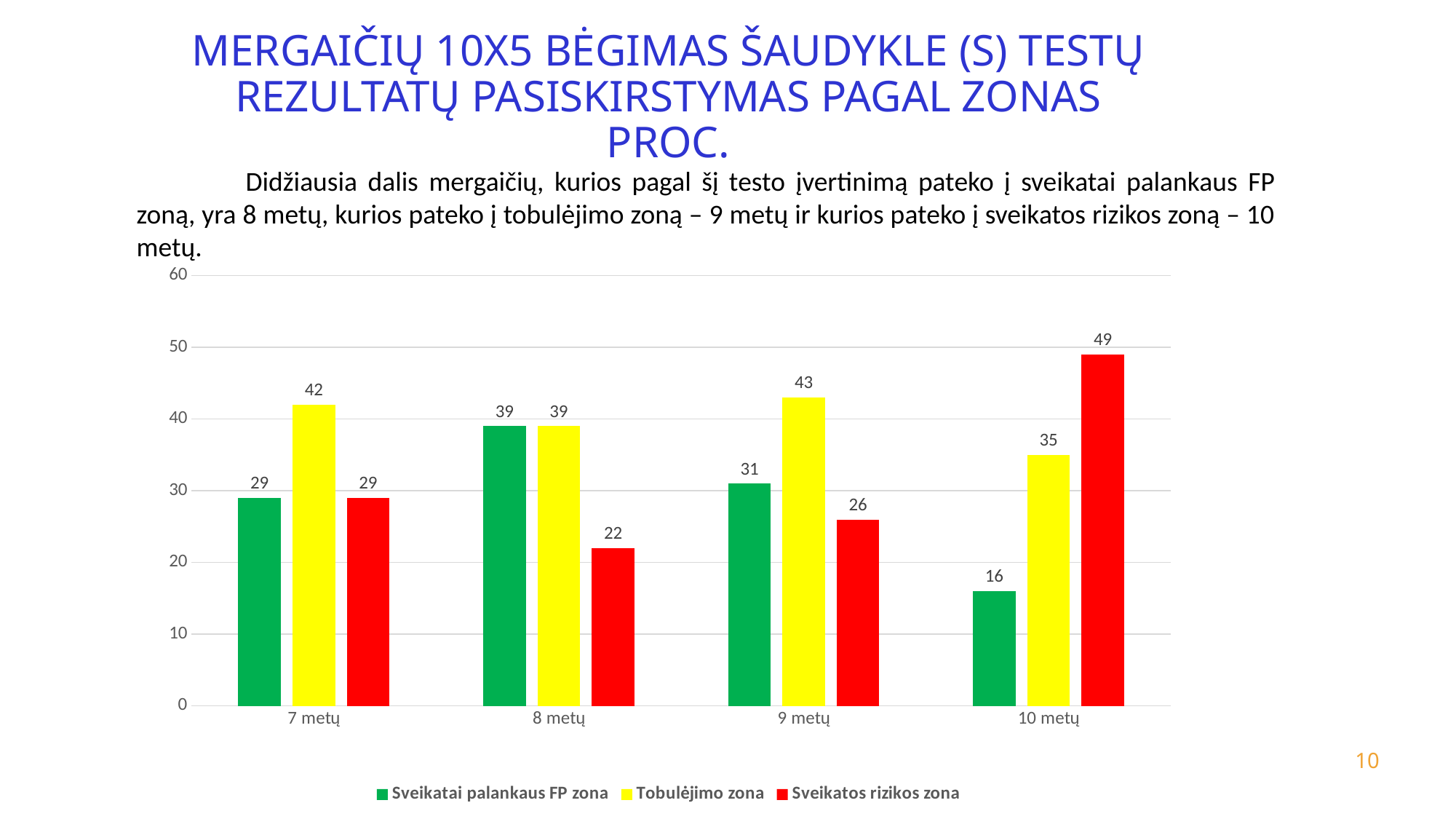
What is the difference between the Tobulėjimo zona and Sveikatos rizikos zona values at 8 metų? 17 What is the value for Tobulėjimo zona at 9 metų? 43 What is the value for Sveikatos rizikos zona at 10 metų? 49 What kind of chart is shown on the slide? Bar chart Do the values for Sveikatai palankaus FP zona rise or fall from 8 metų to 10 metų? Fall Which is larger at 9 metų: Sveikatai palankaus FP zona or Sveikatos rizikos zona? Sveikatai palankaus FP zona How many age groups are shown on the x axis? 4 How many series does the legend list? 3 Which age group has the lowest value for Sveikatai palankaus FP zona? 10 metų Which colour represents Tobulėjimo zona in the chart? Yellow What is the value for Sveikatai palankaus FP zona at 8 metų? 39 Which age group has the highest value for Sveikatos rizikos zona? 10 metų